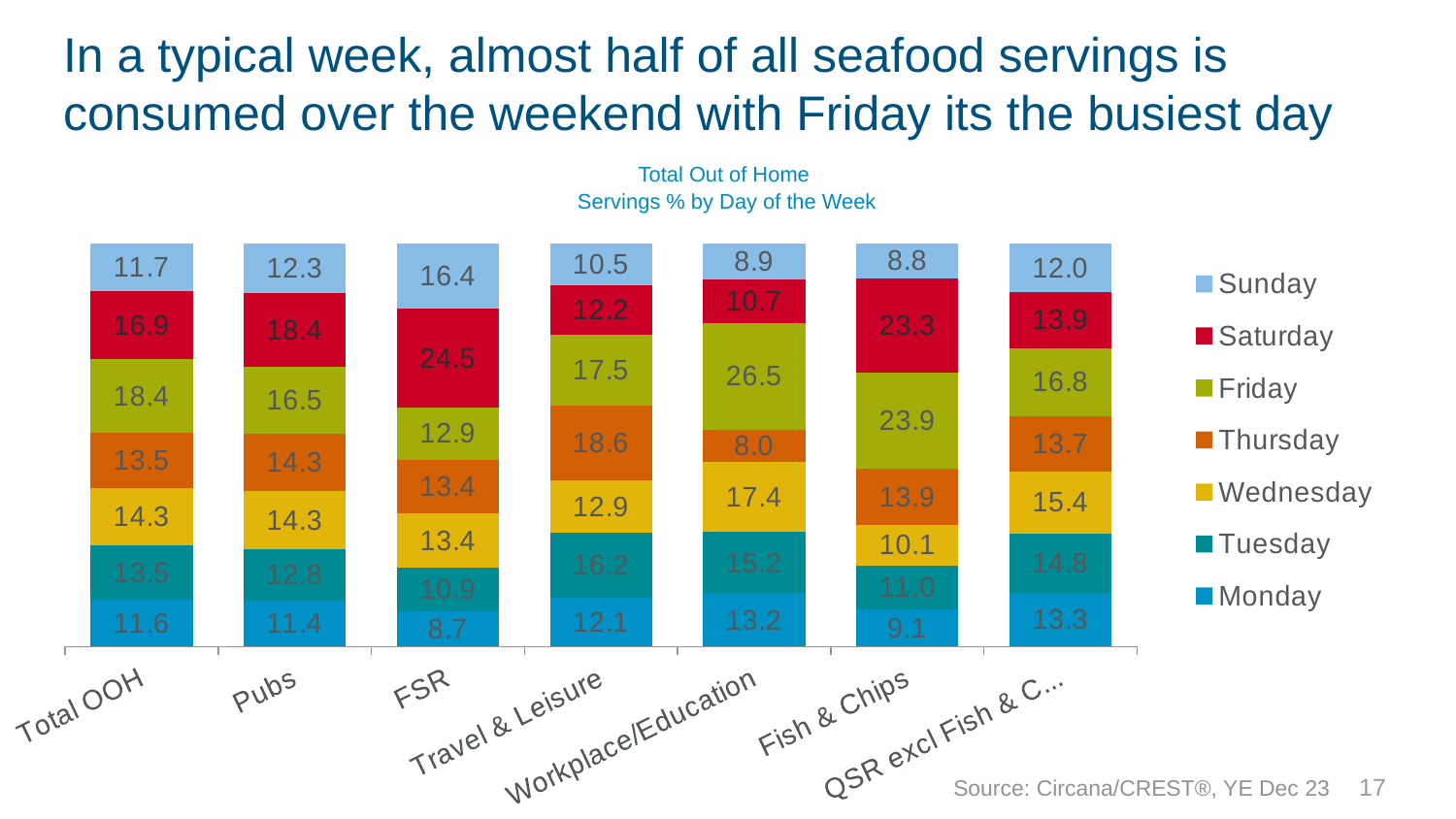
What is the difference between the Friday and Sunday values for Total OOH? 6.7 What is the Friday value for Workplace/Education? 26.5 How many series does the legend list? 7 For Pubs, which is larger: the Saturday value or the Friday value? Saturday What is the Monday value for Total OOH? 11.6 What is the Thursday value for Travel & Leisure? 18.6 Which category has the highest Saturday value? FSR How many categories are shown on the x axis? 7 Which category has the lowest Thursday value? Workplace/Education What kind of chart is shown on the slide? Stacked bar chart What is the Saturday value for FSR? 24.5 Which category has the highest Friday value? Workplace/Education